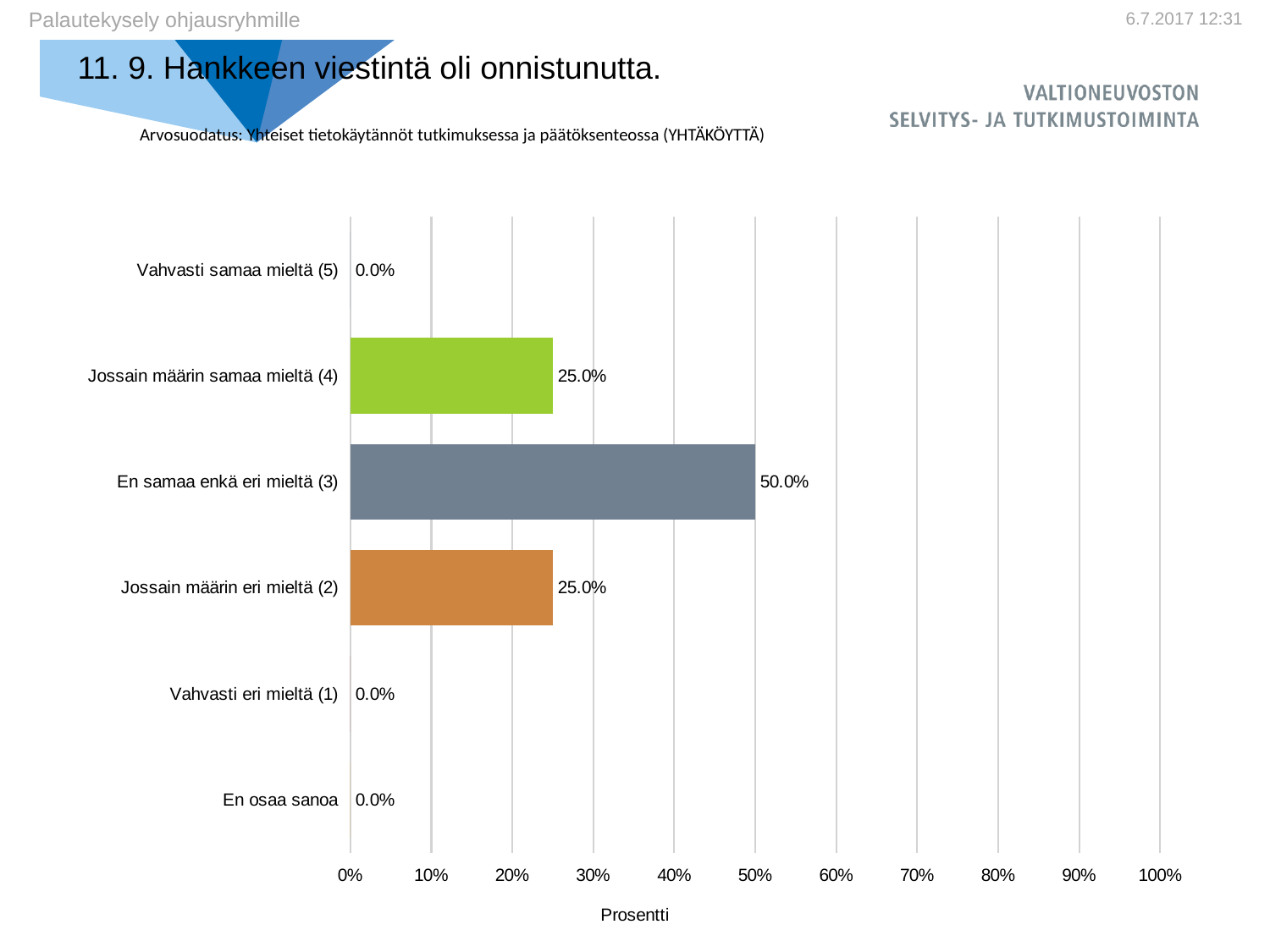
What is the value for "Jossain määrin samaa mieltä (4)"? 25.0% Which category has the highest value? En samaa enkä eri mieltä (3) What is the value for "En samaa enkä eri mieltä (3)"? 50.0% What is the title of the chart? 11. 9. Hankkeen viestintä oli onnistunutta. What kind of chart is shown on the slide? bar chart What is the value for "En osaa sanoa"? 0.0% Which is larger, the value for "En samaa enkä eri mieltä (3)" or the value for "Jossain määrin samaa mieltä (4)"? En samaa enkä eri mieltä (3) What is the label of the horizontal axis? Prosentti What is the value for "Vahvasti samaa mieltä (5)"? 0.0% How many categories are shown on the chart? 6 What is the difference between the values for "En samaa enkä eri mieltä (3)" and "Jossain määrin eri mieltä (2)"? 25.0% Is the value for "Jossain määrin eri mieltä (2)" greater or less than 40%? less